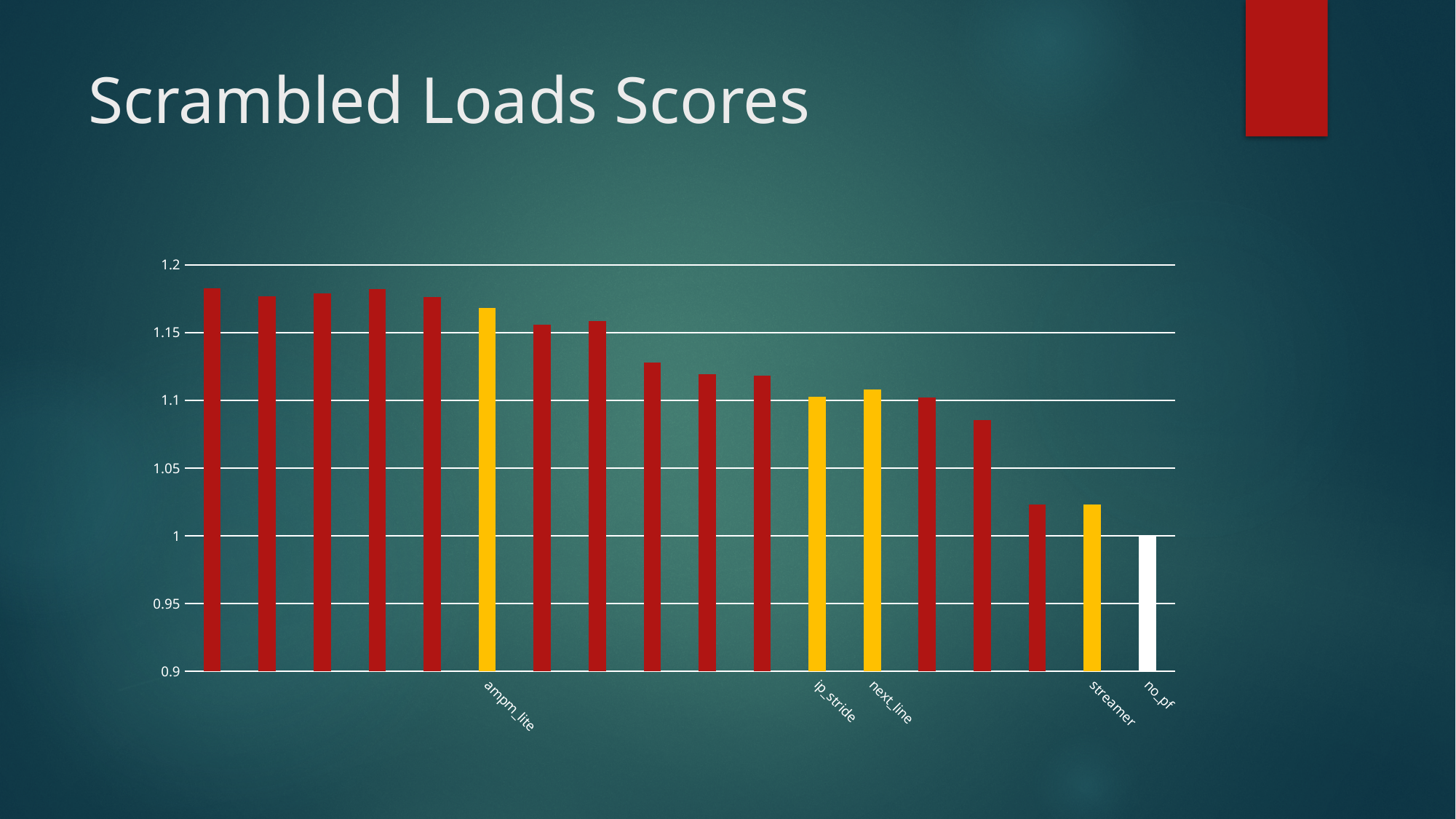
Is the value for next_line greater or less than 1.05? greater Is the value for streamer greater or less than 1.05? less Do the bar values generally rise or fall from left to right along the x axis? fall Which labelled category has the lowest value? no_pf What is the title of the chart? Scrambled Loads Scores Is the value for ip_stride greater or less than 1.15? less Which is larger, the value for ampm_lite or the value for streamer? ampm_lite What is the value for no_pf? 1 How many bars are plotted in the chart? 18 What kind of chart is shown on the slide? bar chart What colour is the bar for no_pf? white